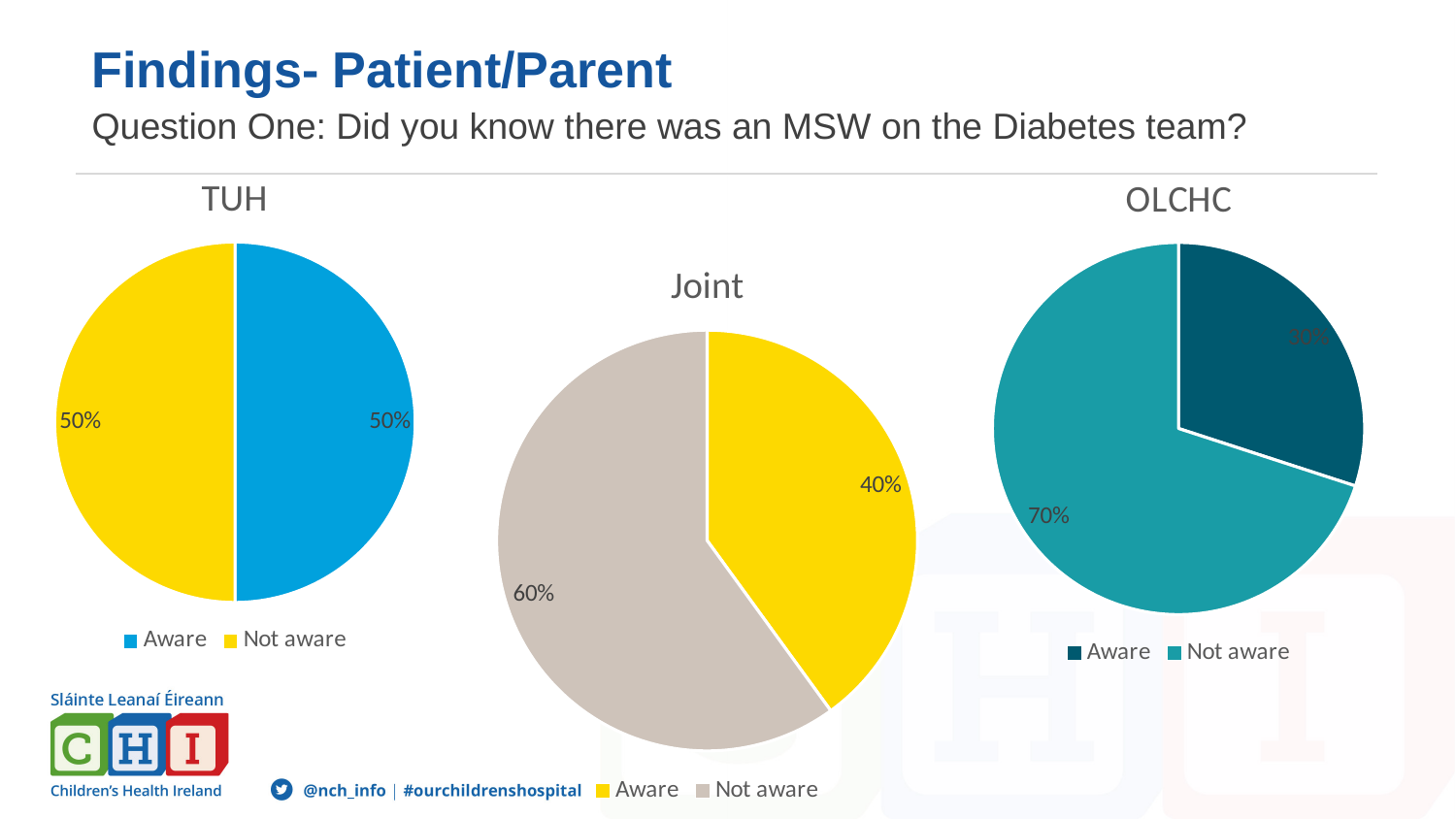
How many entries does the legend of the OLCHC chart list? 2 In the Joint chart, what share of respondents were Not aware? 60% In the Joint chart, which slice is larger, Aware or Not aware? Not aware What kind of chart is the TUH chart? pie chart In the Joint chart, what is the difference between the Not aware and Aware shares? 20% In the TUH chart, what share of respondents were Not aware? 50% In the OLCHC chart, which slice is larger, Aware or Not aware? Not aware In the Joint chart, what share of respondents were Aware? 40% In the OLCHC chart, what share of respondents were Not aware? 70% In the TUH chart, what share of respondents were Aware? 50% In the Joint chart, what colour is the Not aware slice? grey How many slices does the Joint pie chart have? 2